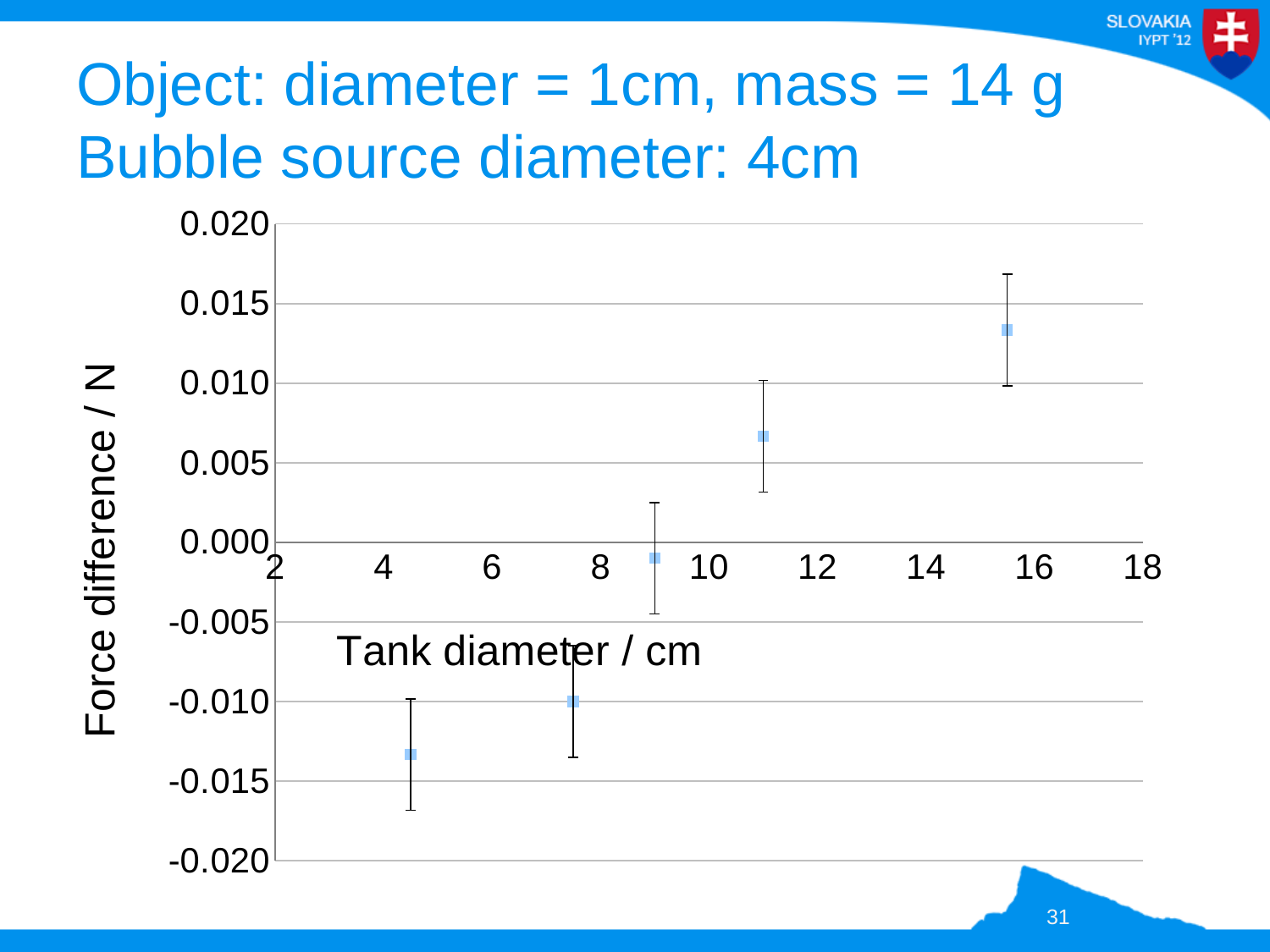
What is the label of the y axis? Force difference / N Is the force difference for the point at a tank diameter of about 11 cm greater or less than 0.005? greater Is the force difference for the point with the smallest tank diameter greater or less than 0.000? less Do the force difference values rise or fall as tank diameter increases along the x axis? rise Is the force difference for the point with the largest tank diameter greater or less than 0.010? greater What is the label of the x axis? Tank diameter / cm Which point has the highest force difference: the one with the smallest tank diameter or the one with the largest tank diameter? the one with the largest tank diameter What is the maximum value shown on the y axis? 0.020 How many data points are plotted on the chart? 5 What kind of chart is shown on the slide? scatter chart